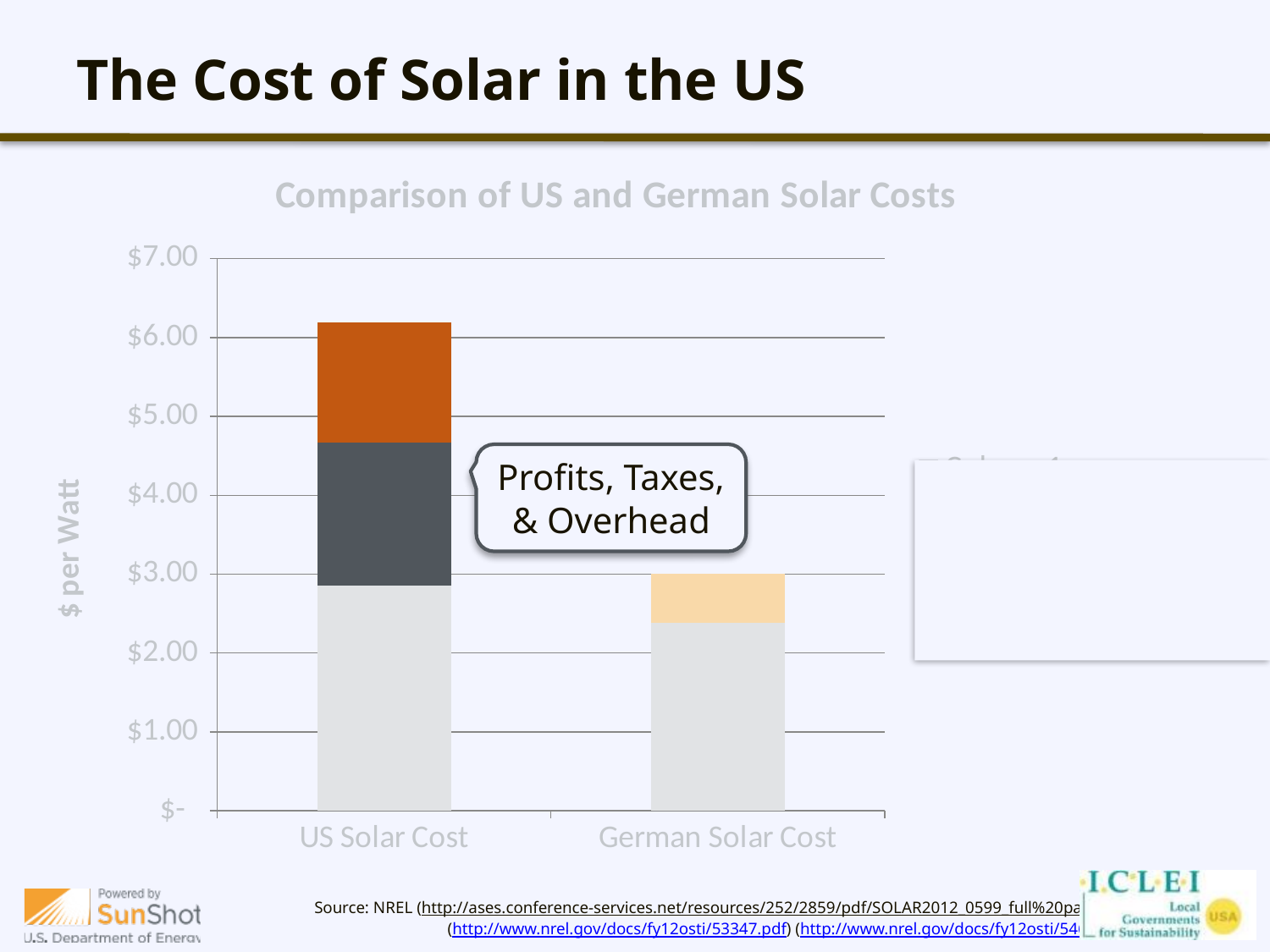
How many categories are shown on the x axis of the chart? 2 What is the title of the chart? Comparison of US and German Solar Costs What is the label on the vertical axis of the chart? $ per Watt How many stacked segments make up the US Solar Cost bar? 3 Which category has the highest total bar? US Solar Cost Which is larger, the total for US Solar Cost or the total for German Solar Cost? US Solar Cost Is the total value for German Solar Cost greater or less than $4.00? less Is the total value for US Solar Cost greater or less than $6.00? greater Is the total value for US Solar Cost greater or less than $7.00? less Which category has the lowest total bar? German Solar Cost What kind of chart is shown on the slide? bar chart